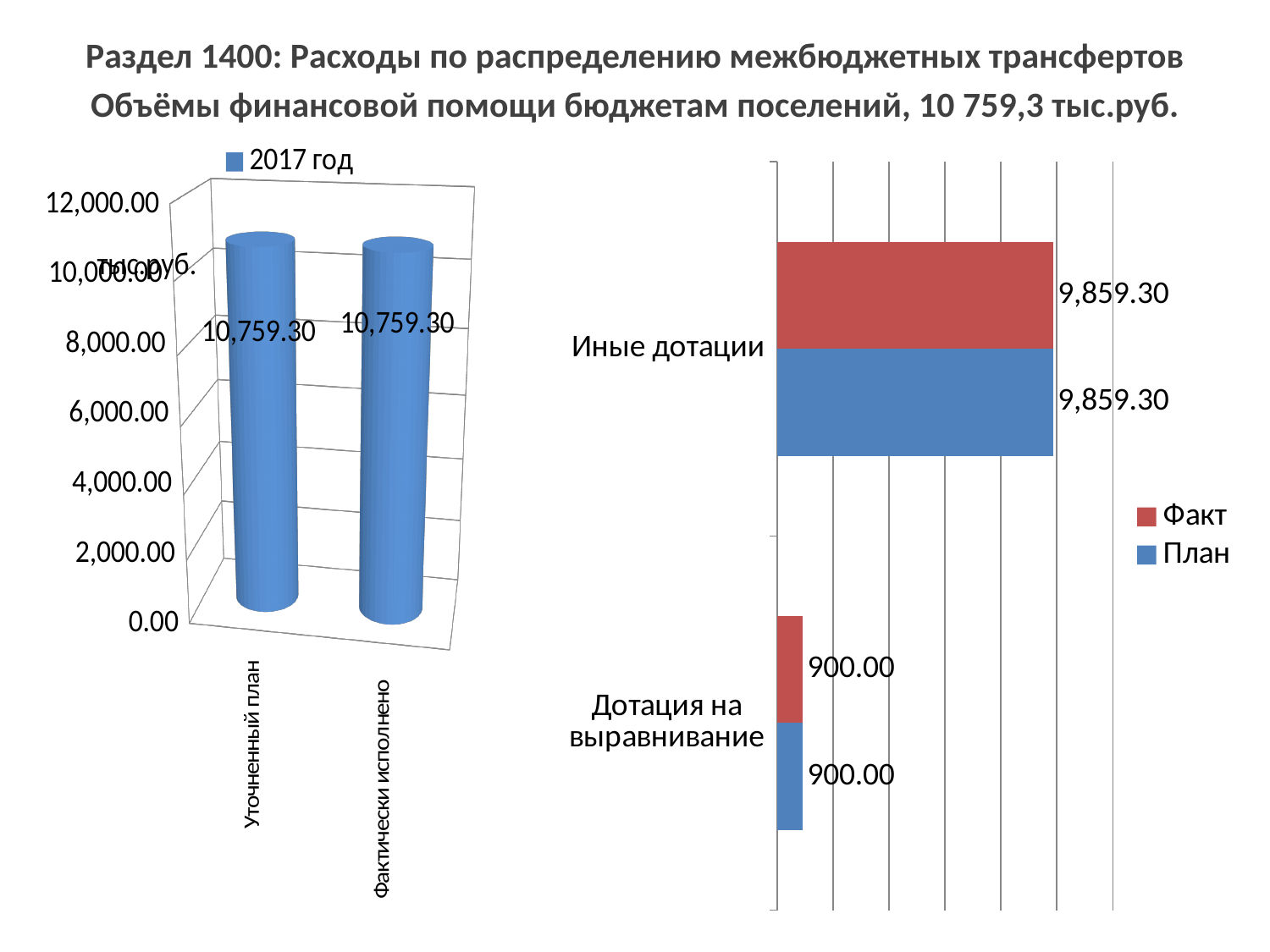
In the left chart, what is the value for Уточненный план? 10,759.30 In the left chart, what is the value for Фактически исполнено? 10,759.30 In the left chart, what is the difference between Уточненный план and Фактически исполнено? 0.00 What kind of chart is the right chart? Bar chart In the left chart, how many categories are shown on the x axis? 2 In the right chart, how many series does the legend list? 2 In the right chart, what is the difference between the План values for Иные дотации and Дотация на выравнивание? 8,959.30 In the left chart, what series does the legend list? 2017 год In the right chart, what is the План value for Иные дотации? 9,859.30 In the right chart, what is the Факт value for Дотация на выравнивание? 900.00 In the right chart, which category has the lowest План value? Дотация на выравнивание In the right chart, which category has the highest Факт value? Иные дотации